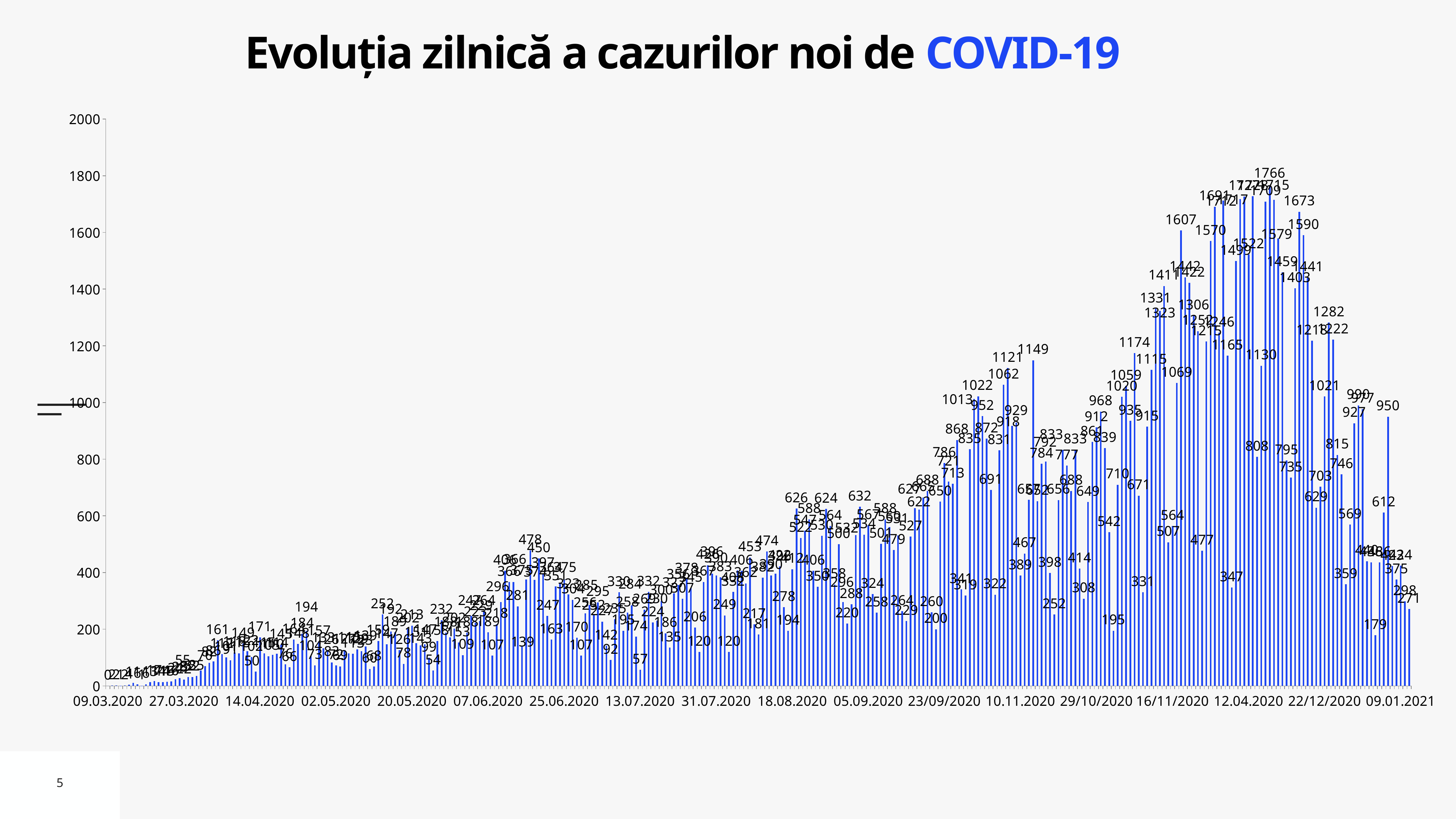
What is the last date label on the horizontal axis? 09.01.2021 Overall, do the daily case values rise or fall from March 2020 to December 2020? rise What is the maximum value shown on the vertical axis? 2000 What kind of chart is shown on the slide? bar chart Is the value of the last bar on the chart greater or less than 400? less What is the first date label on the horizontal axis? 09.03.2020 What is the title of the chart? Evoluția zilnică a cazurilor noi de COVID-19 Is the value of the first bar on the chart greater or less than 200? less What is the value of the highest bar on the chart? 1766 Is the highest bar on the chart greater or less than 1600? greater